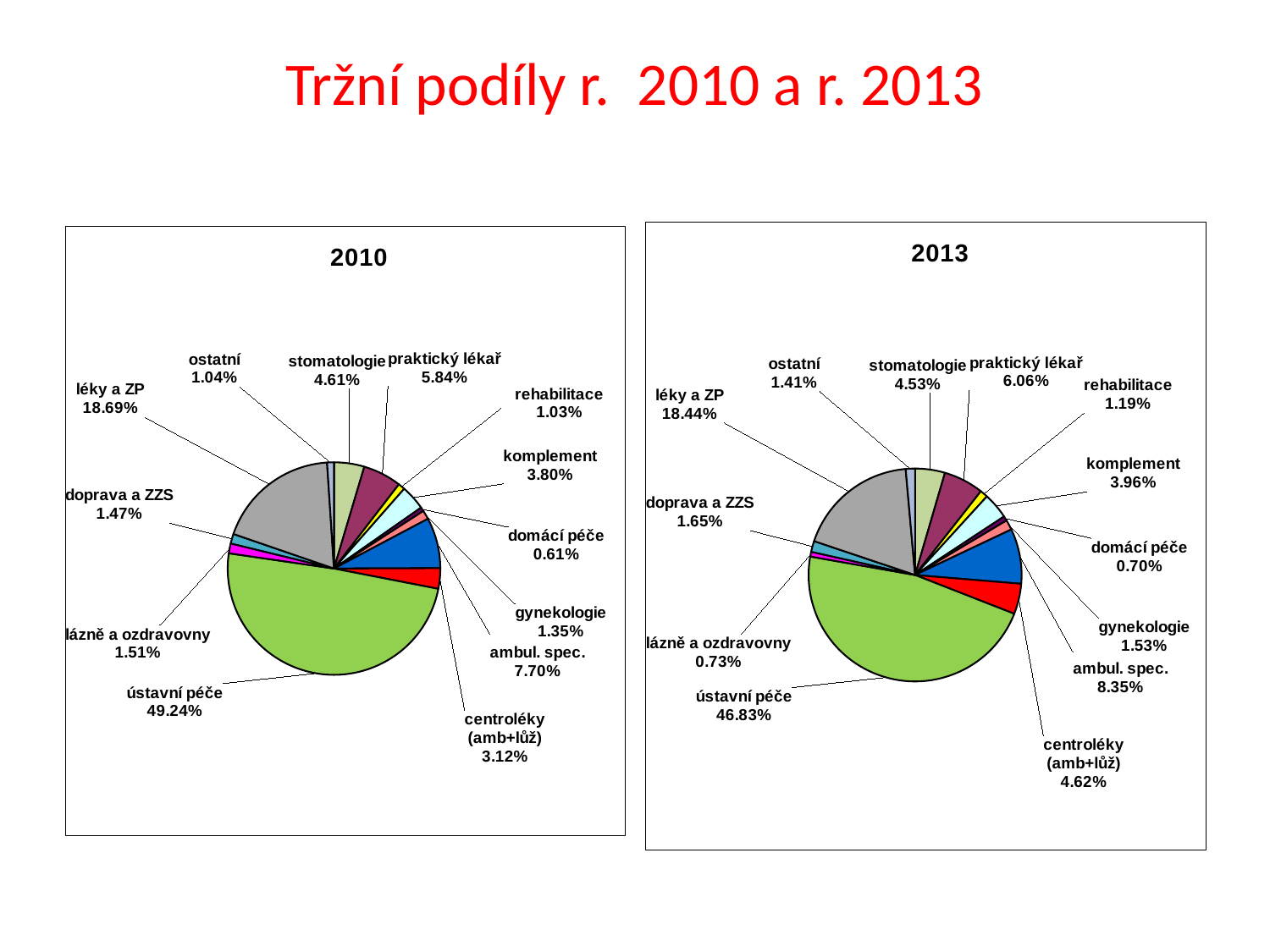
In the 2010 chart, which category has the largest share? ústavní péče What is the difference between the share of ústavní péče in the 2010 chart and in the 2013 chart? 2.41% What type of chart is used for the 2010 data? pie chart In the 2013 chart, what is the share for ambul. spec.? 8.35% In the 2010 chart, what is the share for ústavní péče? 49.24% In the 2013 chart, what is the difference between the shares of praktický lékař and stomatologie? 1.53% How many categories are shown in the 2013 chart? 13 In the 2013 chart, which category has the smallest share? domácí péče In the 2010 chart, which is larger: the share of ambul. spec. or the share of praktický lékař? ambul. spec. In the 2013 chart, what is the share for léky a ZP? 18.44% What is the title of the slide? Tržní podíly r. 2010 a r. 2013 In the 2010 chart, which category has the smallest share? domácí péče